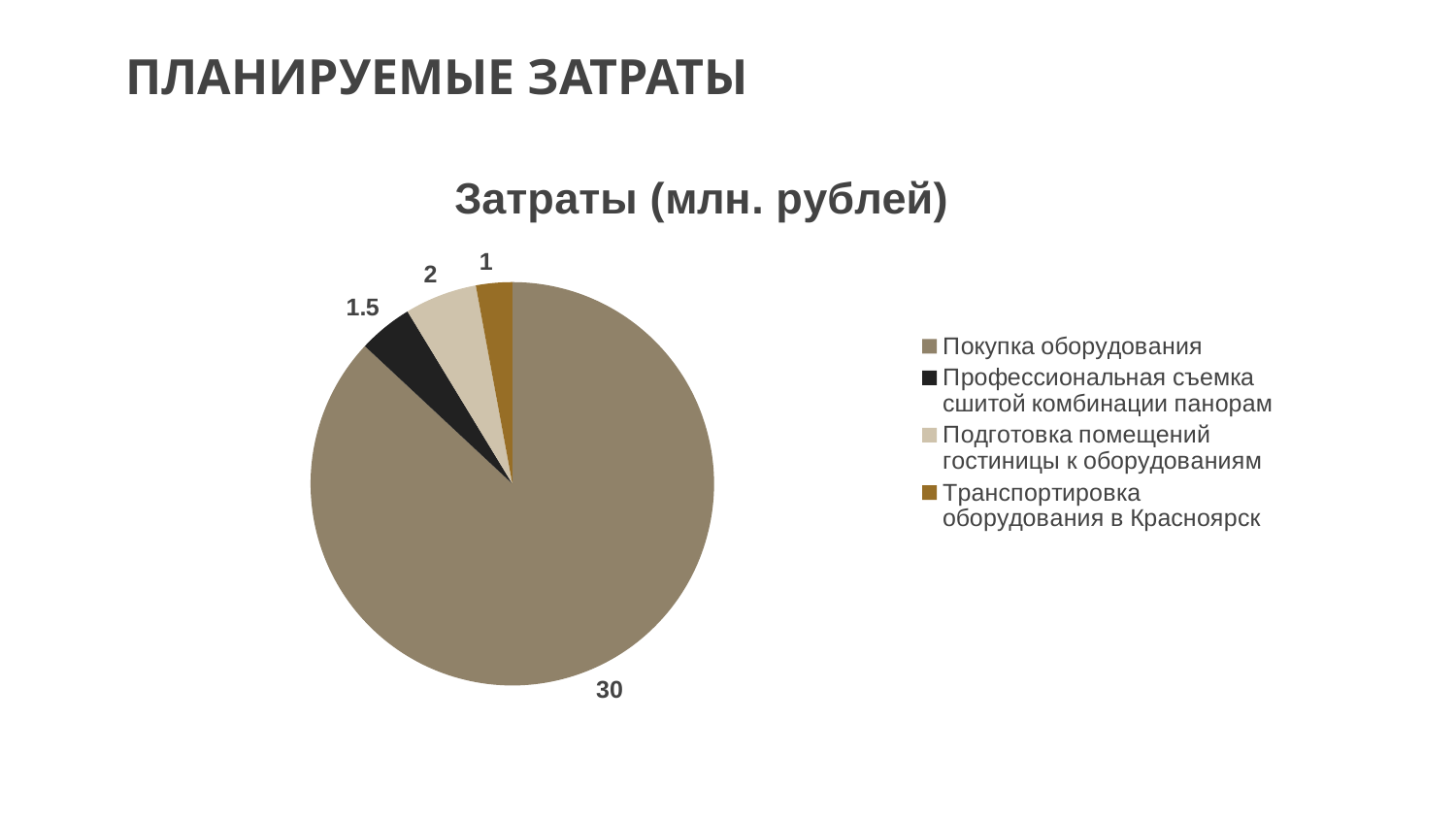
What is the value for Покупка оборудования? 30 How many slices does the pie chart have? 4 What is the value for Профессиональная съемка сшитой комбинации панорам? 1.5 What is the value for Подготовка помещений гостиницы к оборудованиям? 2 What is the total of all the values shown in the pie chart? 34.5 What is the value for Транспортировка оборудования в Красноярск? 1 What is the title of the chart? Затраты (млн. рублей) What is the difference between the values for Покупка оборудования and Подготовка помещений гостиницы к оборудованиям? 28 What type of chart is shown on the slide? pie chart Which category has the smallest slice of the pie? Транспортировка оборудования в Красноярск Which category has the largest slice of the pie? Покупка оборудования Which is larger: the value for Подготовка помещений гостиницы к оборудованиям or the value for Профессиональная съемка сшитой комбинации панорам? Подготовка помещений гостиницы к оборудованиям